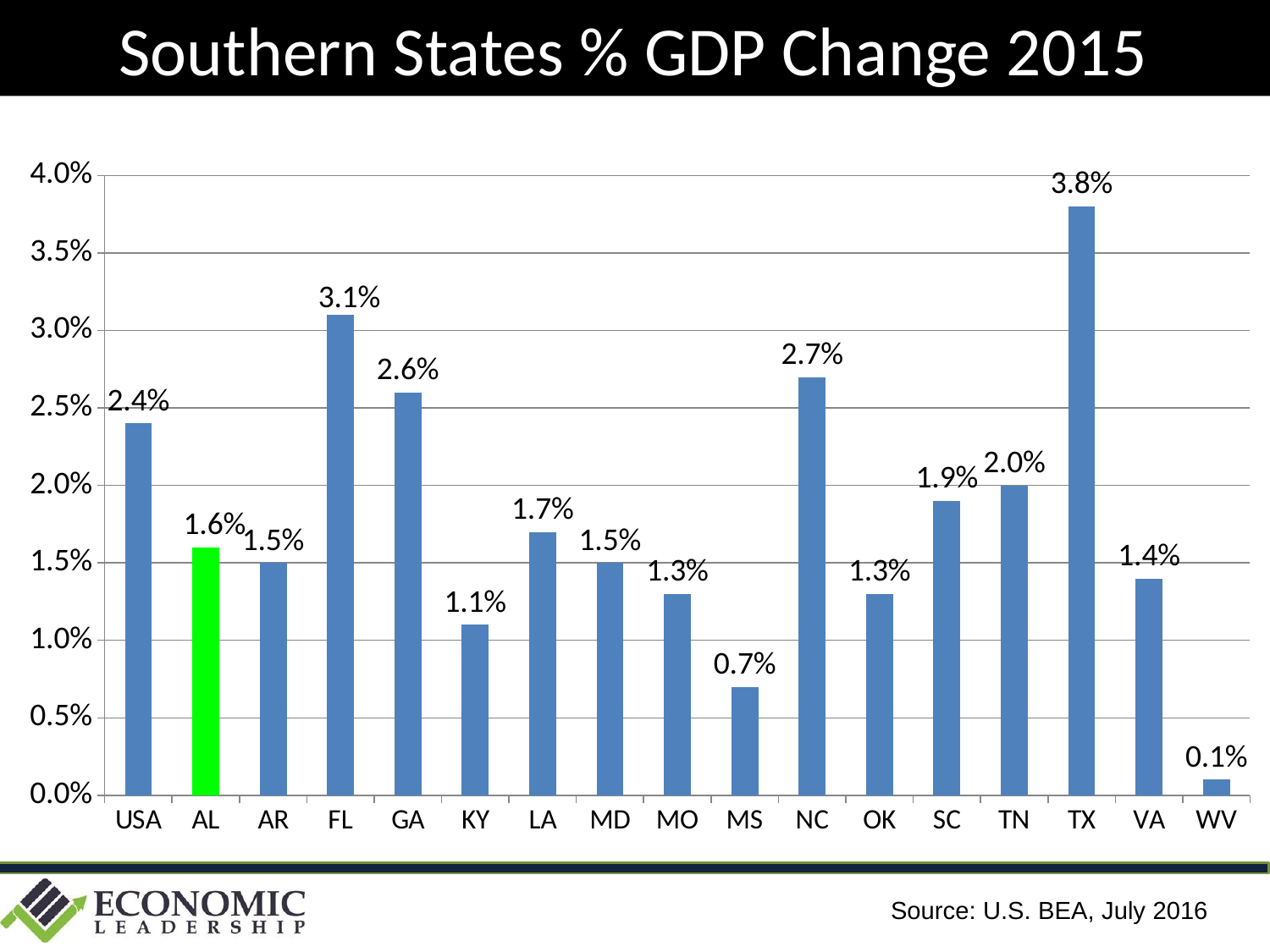
What is the % GDP change shown for TX? 3.8% How many categories are shown on the x axis? 17 What kind of chart is shown on the slide? bar chart Which category has the highest % GDP change? TX Which bar is coloured green instead of blue? AL What is the % GDP change shown for USA? 2.4% What is the difference between the % GDP change for FL and GA? 0.5% Is the value for MS greater or less than 1.0%? less What is the title of the chart? Southern States % GDP Change 2015 Which has a larger % GDP change, NC or SC? NC Which category has the lowest % GDP change? WV What is the % GDP change shown for AL? 1.6%